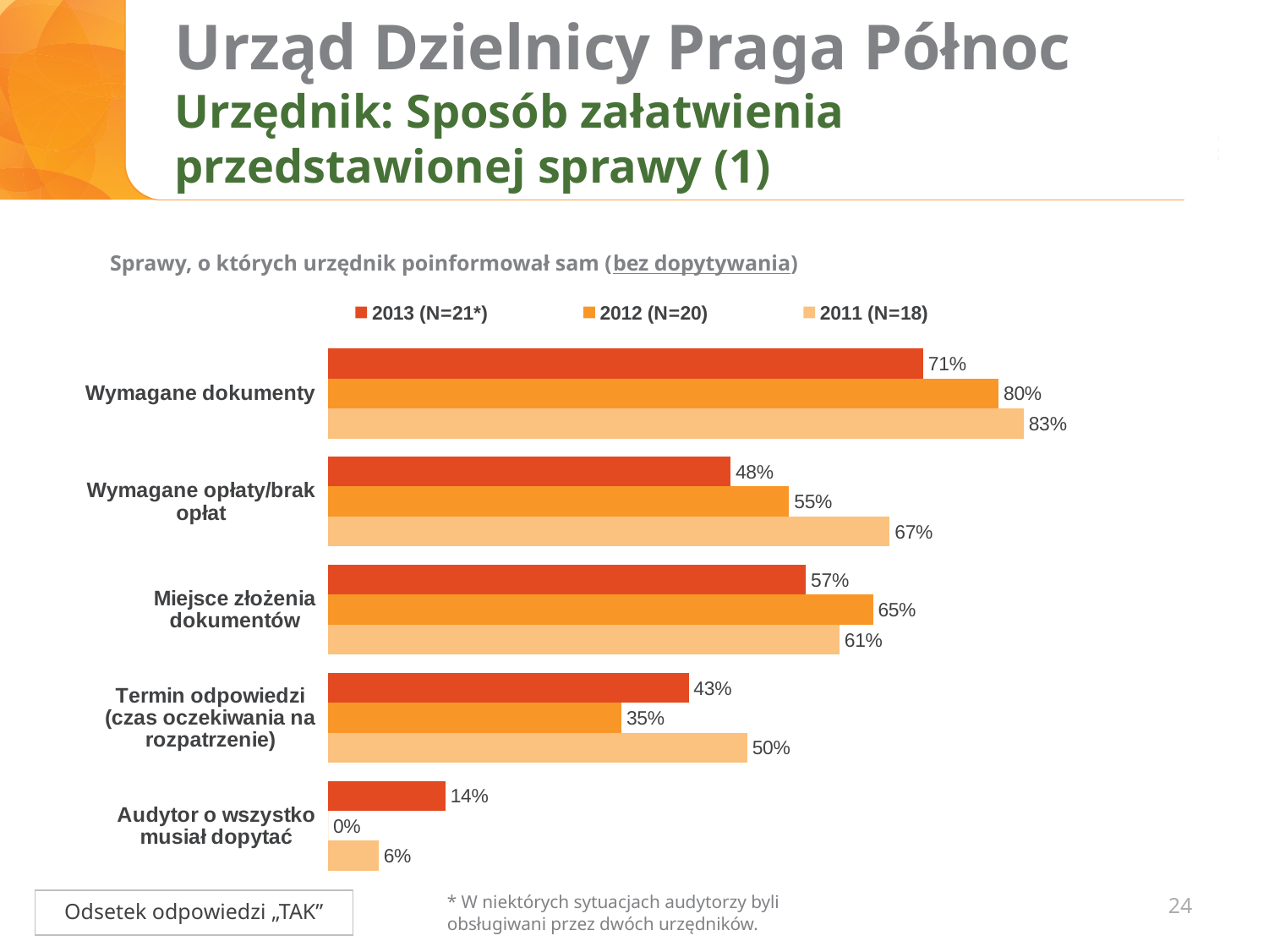
What is the value for 'Wymagane dokumenty' in the 2013 (N=21*) series? 71% What is the value for 'Audytor o wszystko musiał dopytać' in the 2011 (N=18) series? 6% What is the value for 'Audytor o wszystko musiał dopytać' in the 2012 (N=20) series? 0% What is the value for 'Termin odpowiedzi (czas oczekiwania na rozpatrzenie)' in the 2012 (N=20) series? 35% Which is larger for 'Miejsce złożenia dokumentów': the 2012 (N=20) value or the 2011 (N=18) value? 2012 (N=20) What kind of chart is shown on the slide? Bar chart What is the subtitle printed above the chart? Sprawy, o których urzędnik poinformował sam (bez dopytywania) Which category has the lowest value in the 2013 (N=21*) series? Audytor o wszystko musiał dopytać How many categories are shown on the chart? 5 How many series does the legend list? 3 What is the difference between the 2011 (N=18) and 2013 (N=21*) values for 'Wymagane opłaty/brak opłat'? 19 percentage points Which category has the highest value in the 2011 (N=18) series? Wymagane dokumenty